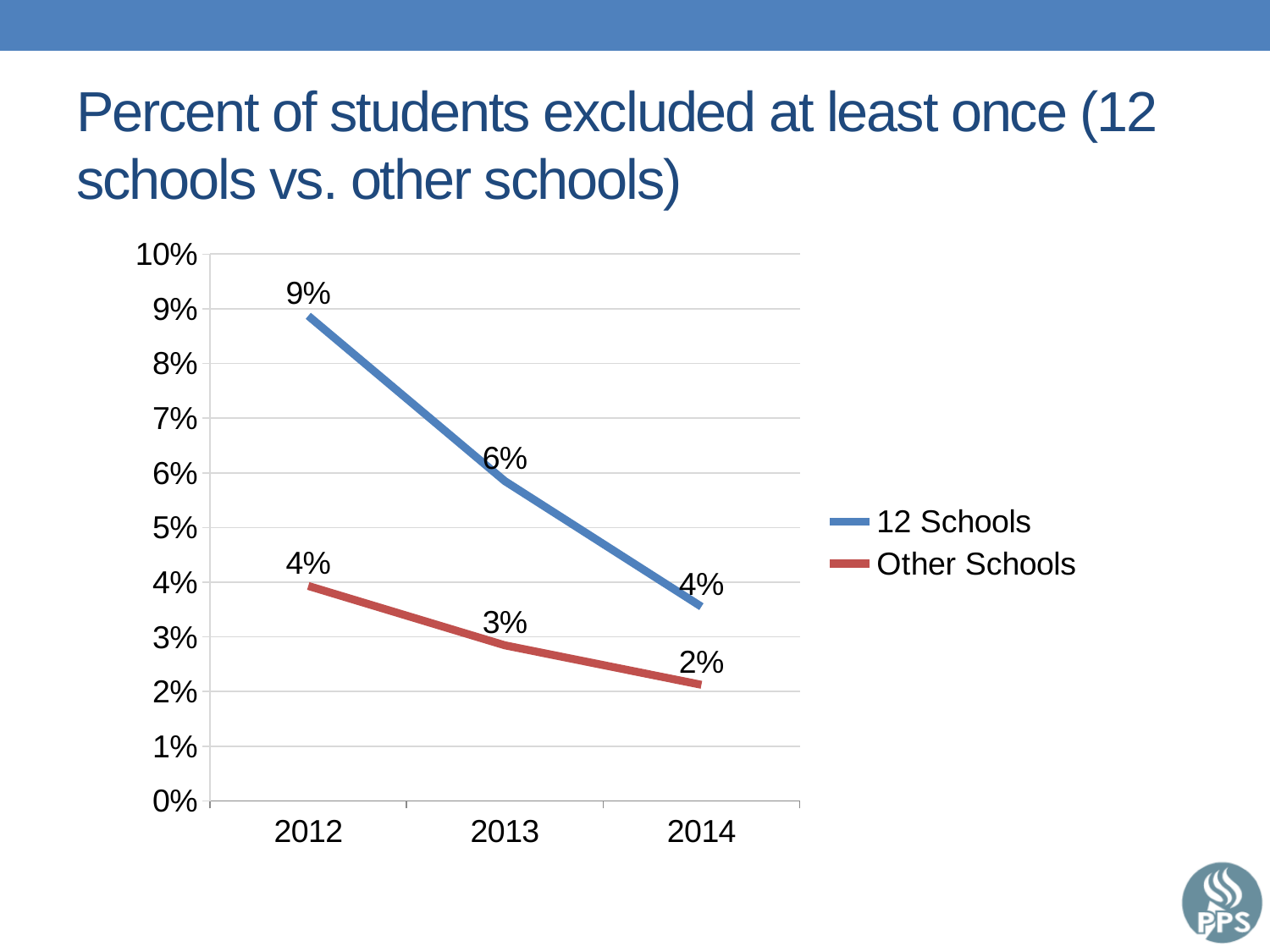
What is the difference between the 12 Schools value and the Other Schools value in 2012? 5% In which year is the value for 12 Schools highest? 2012 Do the values for 12 Schools rise or fall from 2012 to 2014? Fall What is the value for 12 Schools in 2014? 4% What is the value for 12 Schools in 2012? 9% How many series does the legend list? 2 Which series has the larger value in 2013, 12 Schools or Other Schools? 12 Schools How many years are shown on the x axis? 3 What kind of chart is shown on the slide? Line chart What is the value for Other Schools in 2014? 2% What is the value for Other Schools in 2013? 3% In which year is the value for Other Schools lowest? 2014